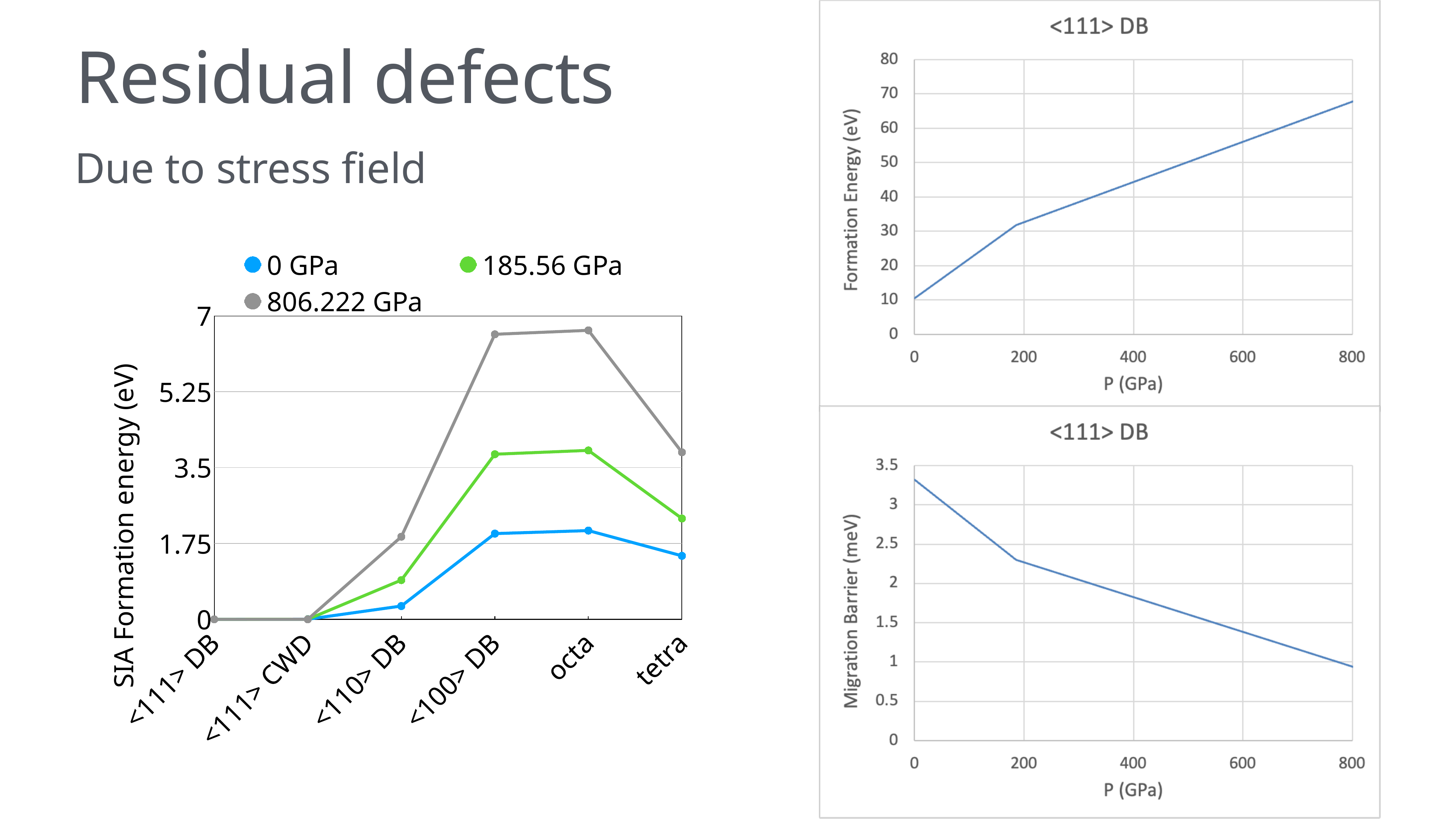
In the left SIA Formation energy chart, what is the value for <111> DB in the 0 GPa series? 0 In the left SIA Formation energy chart, how many series does the legend list? 3 In the bottom-right <111> DB chart, is the Migration Barrier at 0 GPa greater or less than 3? greater In the left SIA Formation energy chart, how many defect categories are shown on the x axis? 6 In the top-right <111> DB chart, is the Formation Energy at 800 GPa greater or less than 60? greater In the left SIA Formation energy chart, which series has the higher value at octa, 185.56 GPa or 0 GPa? 185.56 GPa In the left SIA Formation energy chart, which series is shown in grey? 806.222 GPa In the top-right <111> DB chart, does Formation Energy rise or fall as P increases? rise In the left SIA Formation energy chart, is the 806.222 GPa value for <100> DB greater or less than 5.25? greater In the bottom-right <111> DB chart, does the Migration Barrier rise or fall as P increases? fall What kind of chart is the left chart showing SIA Formation energy? line chart